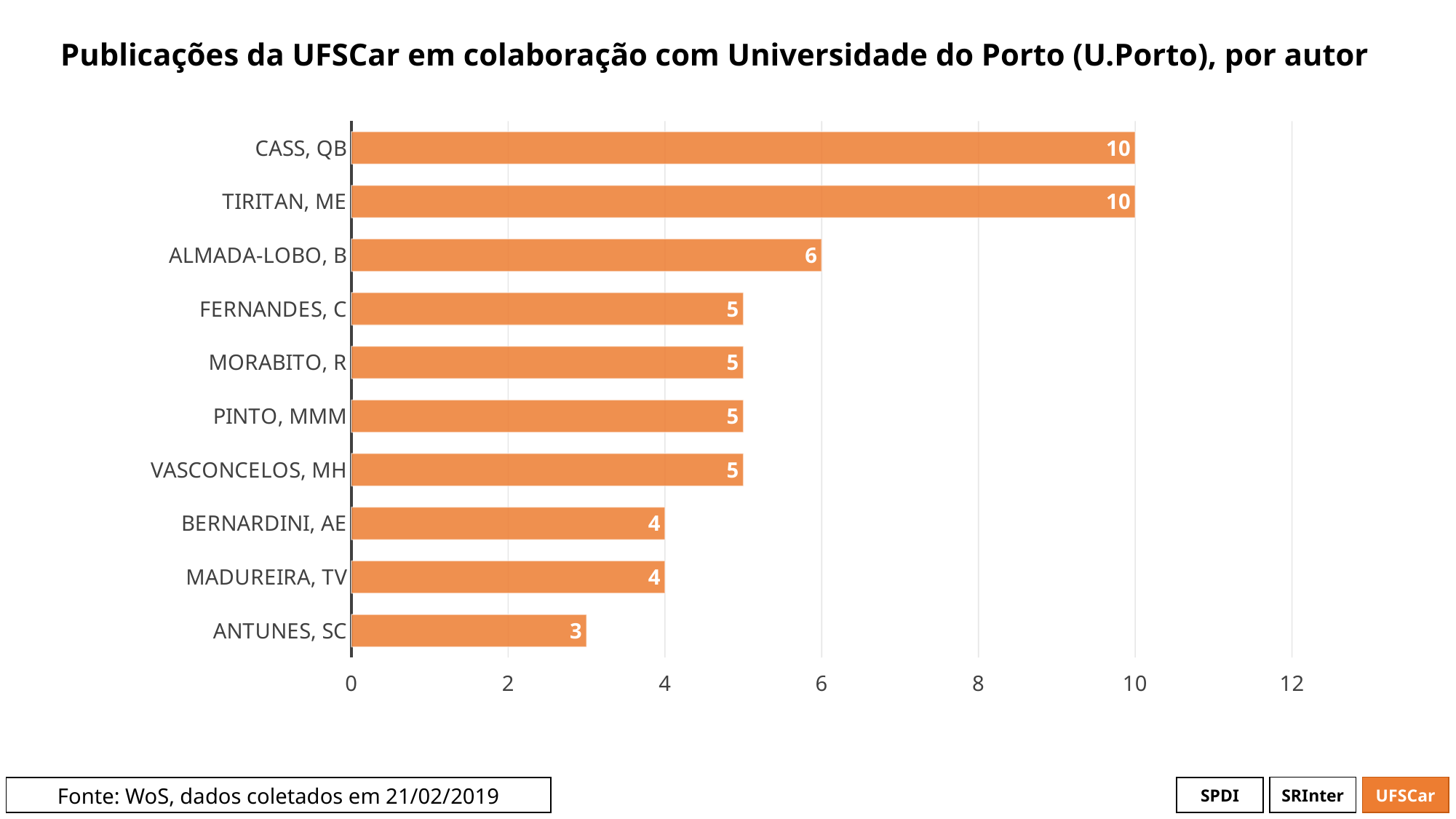
Is the value for ALMADA-LOBO, B greater or less than 4? greater Which author has the lowest number of publications? ANTUNES, SC What is the difference between the values for FERNANDES, C and ANTUNES, SC? 2 What is the title of the chart? Publicações da UFSCar em colaboração com Universidade do Porto (U.Porto), por autor How many publications does ALMADA-LOBO, B have? 6 What kind of chart is shown on the slide? bar chart Which is larger, the value for TIRITAN, ME or the value for MADUREIRA, TV? TIRITAN, ME What is the value for BERNARDINI, AE? 4 What is the highest value shown in the chart? 10 What is the value for ANTUNES, SC? 3 What is the difference between the values for CASS, QB and ALMADA-LOBO, B? 4 How many authors are shown in the chart? 10